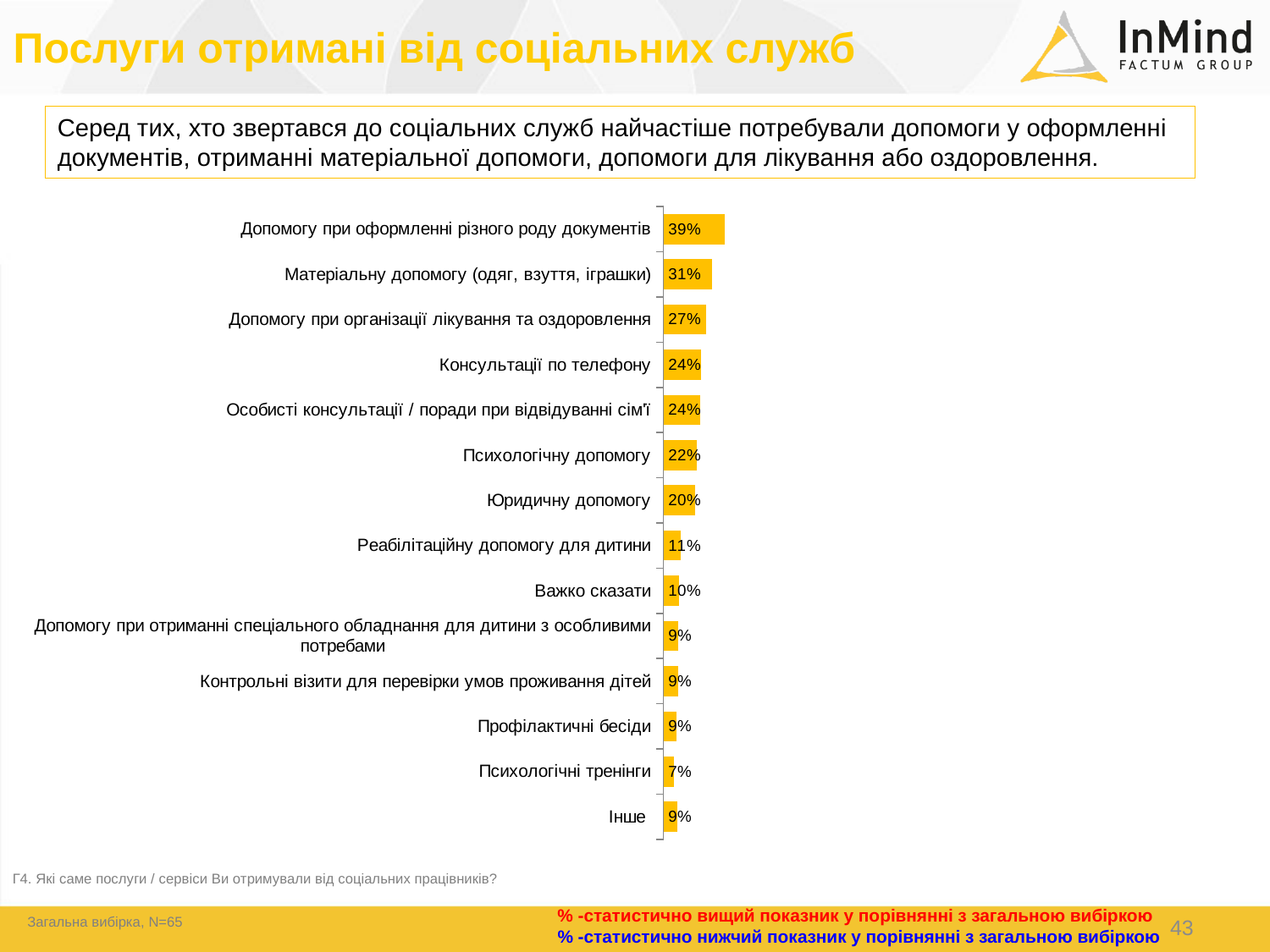
What value is shown for "Матеріальну допомогу (одяг, взуття, іграшки)"? 31% What is the difference between the values for "Допомогу при оформленні різного роду документів" and "Матеріальну допомогу (одяг, взуття, іграшки)"? 8% What percentage is shown for "Допомогу при оформленні різного роду документів"? 39% What percentage is shown for "Психологічну допомогу"? 22% Which category has the highest value on the chart? Допомогу при оформленні різного роду документів What value is shown for "Психологічні тренінги"? 7% Which is larger: the value for "Допомогу при організації лікування та оздоровлення" or for "Консультації по телефону"? Допомогу при організації лікування та оздоровлення What is the value shown for "Інше"? 9% What type of chart is shown on the slide? Bar chart What is the difference between the values for "Юридичну допомогу" and "Реабілітаційну допомогу для дитини"? 9% How many categories are shown on the chart? 14 Which category has the lowest value on the chart? Психологічні тренінги